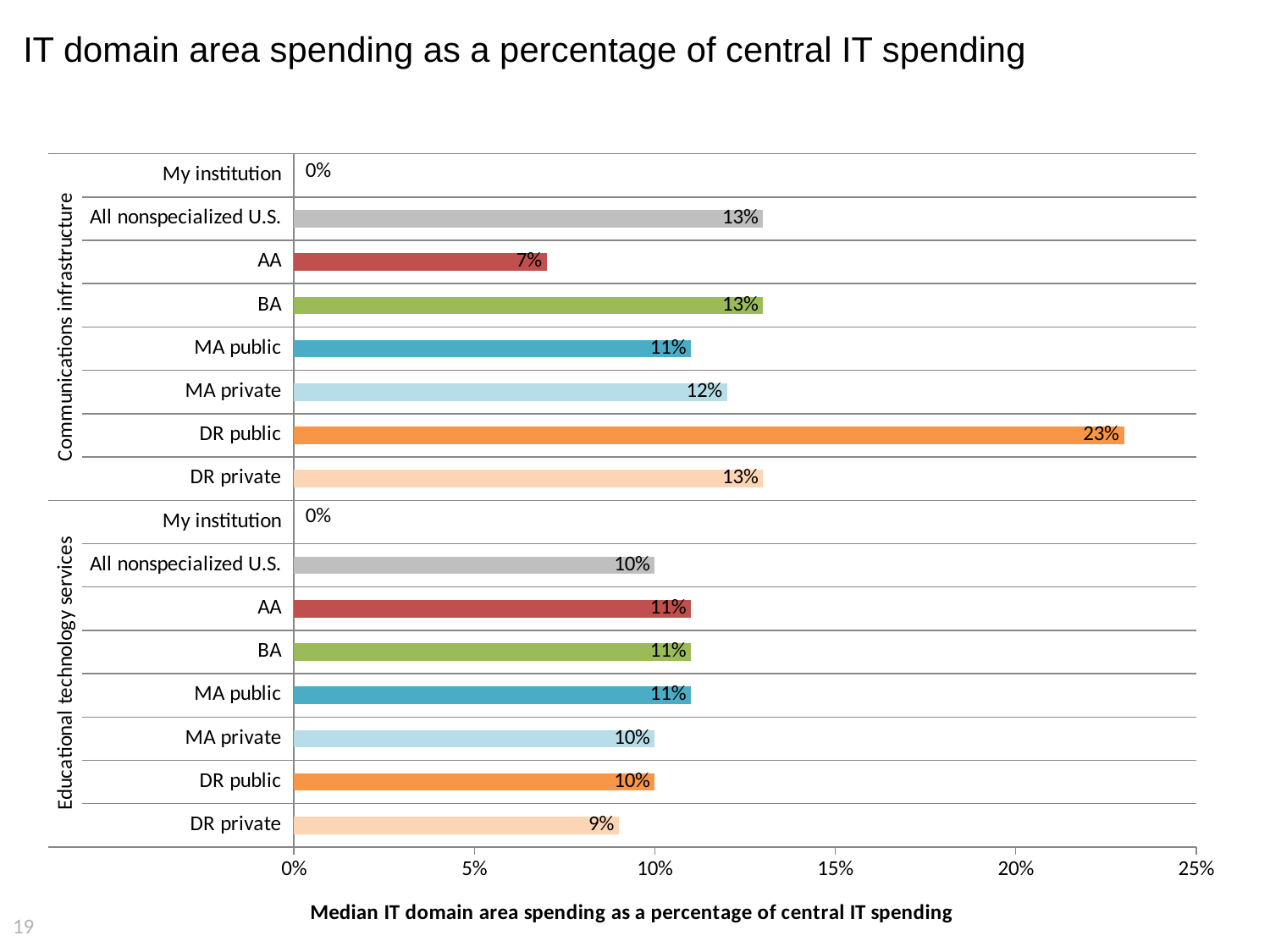
What is the value for DR public under Communications infrastructure? 23% Excluding My institution, which category has the lowest value under Educational technology services? DR private What is the value for AA under Communications infrastructure? 7% How many categories are listed under Educational technology services? 8 What is the value for DR private under Educational technology services? 9% Which is larger: BA under Communications infrastructure or BA under Educational technology services? BA under Communications infrastructure What is the difference between MA private under Communications infrastructure and MA private under Educational technology services? 2% What is the difference between DR public and AA under Communications infrastructure? 16% Excluding My institution, which category has the lowest value under Communications infrastructure? AA What is the value for All nonspecialized U.S. under Educational technology services? 10% What type of chart is shown on the slide? Bar chart Which category has the highest value under Communications infrastructure? DR public